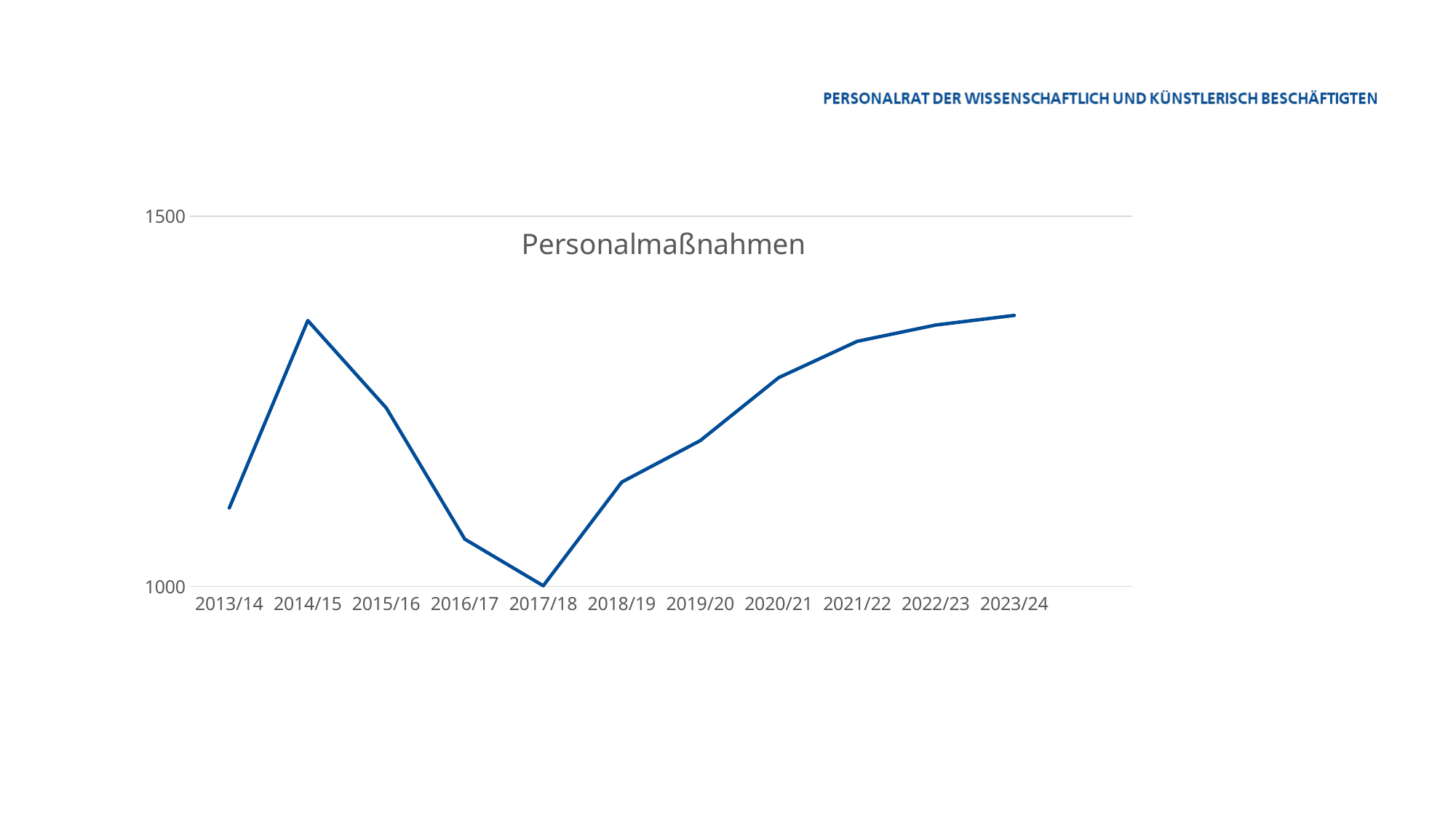
Which is larger, the value for 2013/14 or the value for 2014/15? 2014/15 Do the values rise or fall from 2017/18 to 2023/24? rise Is the value for 2023/24 greater or less than 1000? greater Which is larger, the value for 2016/17 or the value for 2020/21? 2020/21 What is the title of the chart? Personalmaßnahmen Which is larger, the value for 2015/16 or the value for 2018/19? 2015/16 Is the value for 2014/15 greater or less than 1500? less Do the values rise or fall from 2014/15 to 2017/18? fall What kind of chart is shown on the slide? line chart Which year has the lowest value on the chart? 2017/18 How many data points (academic years) are plotted on the x axis? 11 What is the first year shown on the x axis? 2013/14